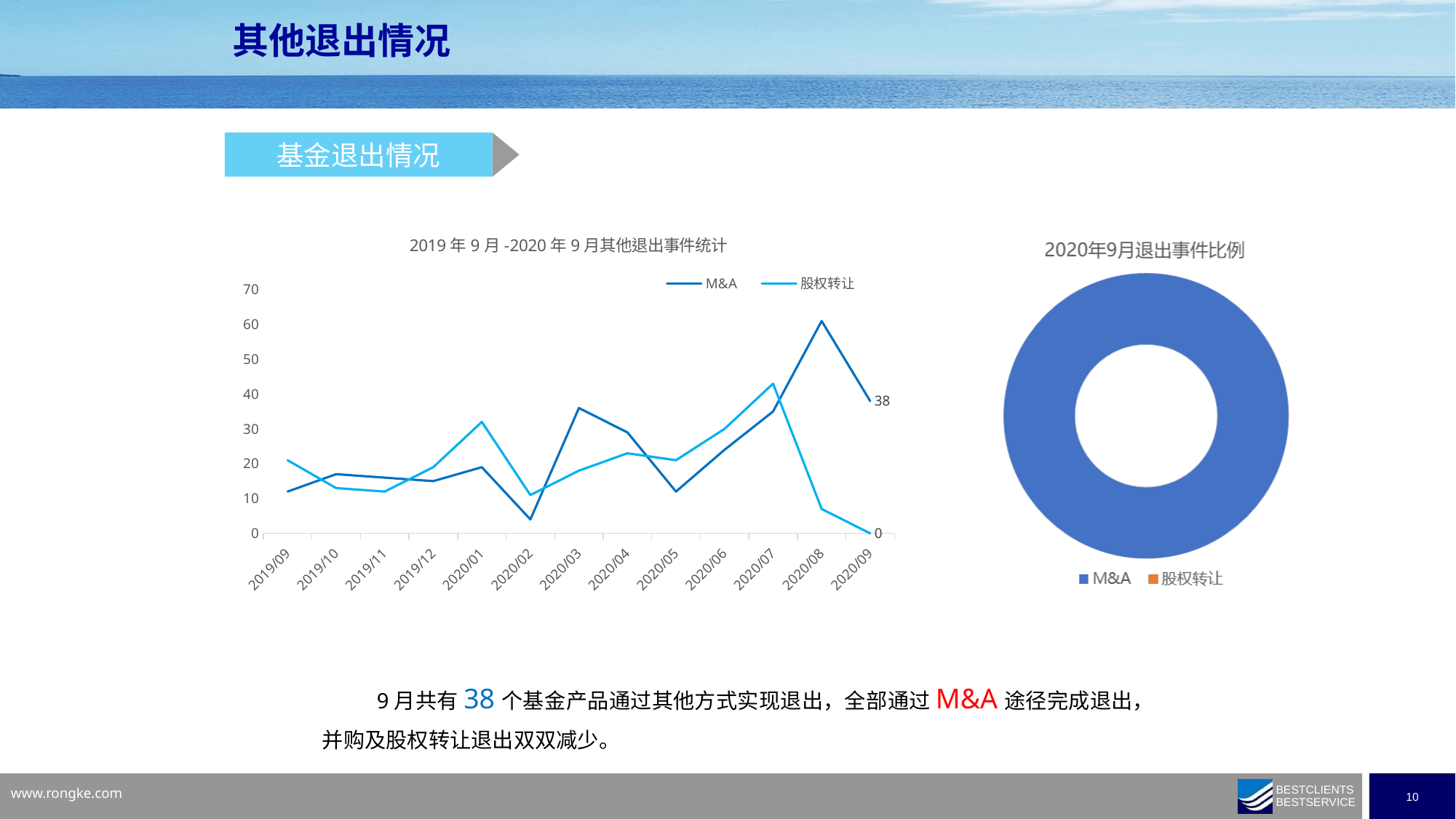
In the line chart '2019年9月-2020年9月其他退出事件统计', in which month is the M&A series highest? 2020/08 In the line chart '2019年9月-2020年9月其他退出事件统计', what is the 股权转让 value for 2020/09? 0 In the line chart '2019年9月-2020年9月其他退出事件统计', in which month is the 股权转让 series highest? 2020/07 What kind of chart is '2019年9月-2020年9月其他退出事件统计'? Line chart What kind of chart is '2020年9月退出事件比例'? Doughnut chart In the line chart '2019年9月-2020年9月其他退出事件统计', is the M&A value for 2020/08 greater or less than 50? greater How many months are shown on the x axis of the line chart '2019年9月-2020年9月其他退出事件统计'? 13 How many series does the legend of the line chart '2019年9月-2020年9月其他退出事件统计' list? 2 In the line chart '2019年9月-2020年9月其他退出事件统计', which series has the larger value in 2020/08, M&A or 股权转让? M&A In the line chart '2019年9月-2020年9月其他退出事件统计', what is the difference between the M&A and 股权转让 values for 2020/09? 38 In the line chart '2019年9月-2020年9月其他退出事件统计', in which month is the M&A series lowest? 2020/02 In the line chart '2019年9月-2020年9月其他退出事件统计', what is the M&A value for 2020/09? 38